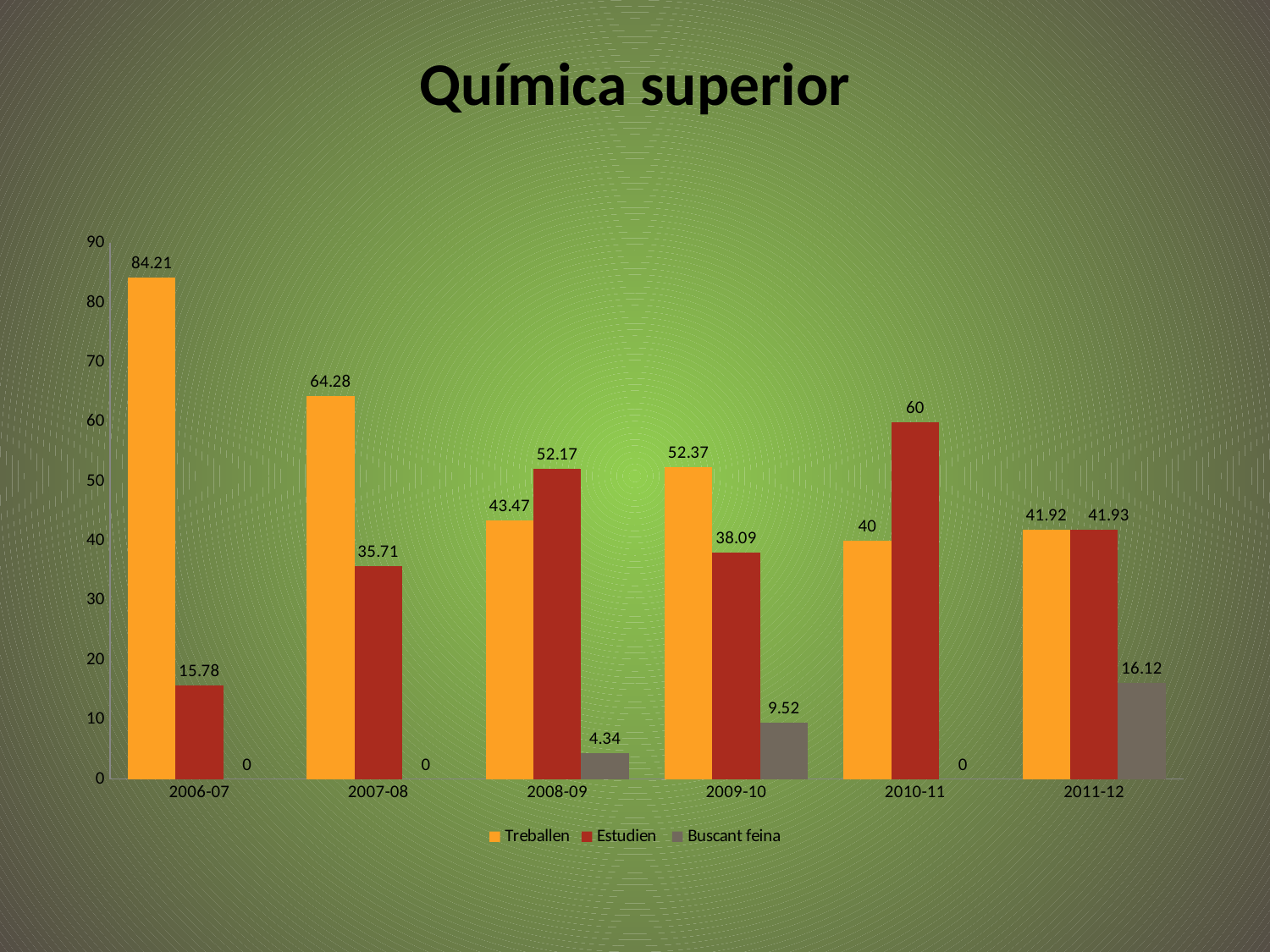
What kind of chart is shown on the slide? bar chart What is the Treballen value for 2006-07? 84.21 How many academic years are shown on the x axis? 6 Which year has the lowest Estudien value? 2006-07 What is the difference between the Treballen and Estudien values in 2007-08? 28.57 Which year has the highest Treballen value? 2006-07 Is the Estudien value for 2009-10 greater or less than 40? less How many series does the legend list? 3 What is the Estudien value for 2010-11? 60 In 2008-09, which is larger, Treballen or Estudien? Estudien What is the Buscant feina value for 2011-12? 16.12 What is the title of the chart? Química superior